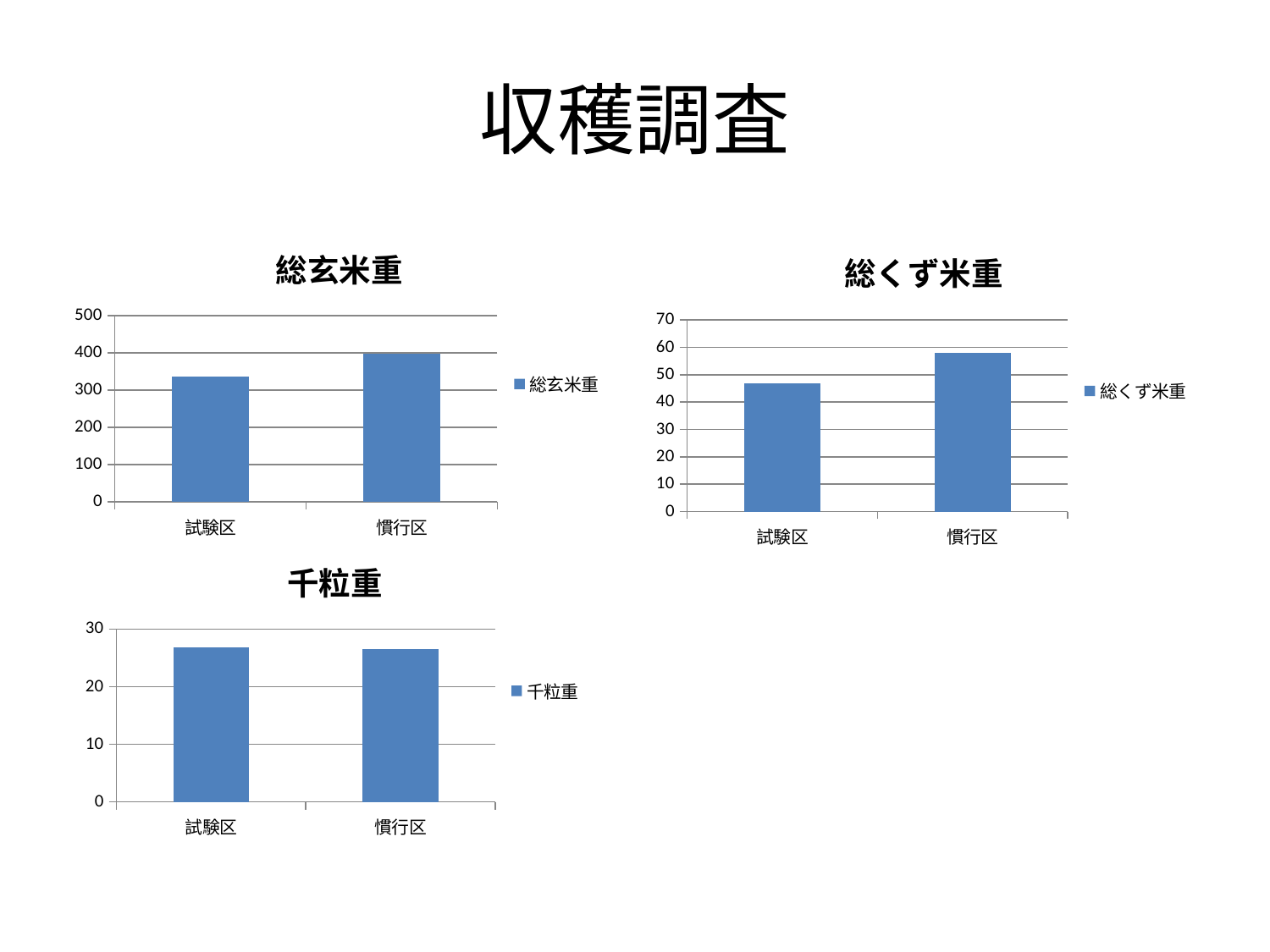
In the 総くず米重 chart, is the value for 慣行区 greater or less than 50? greater In the 総くず米重 chart, is the value for 試験区 greater or less than 50? less How many charts are shown on the slide? 3 In the 総玄米重 chart, is the value for 試験区 greater or less than 300? greater How many categories are shown in the 千粒重 chart? 2 What kind of chart is the 総玄米重 chart? bar chart How many series does the legend of the 総くず米重 chart list? 1 In the 総くず米重 chart, which category has the lowest value? 試験区 In the 総玄米重 chart, which category has the higher value, 試験区 or 慣行区? 慣行区